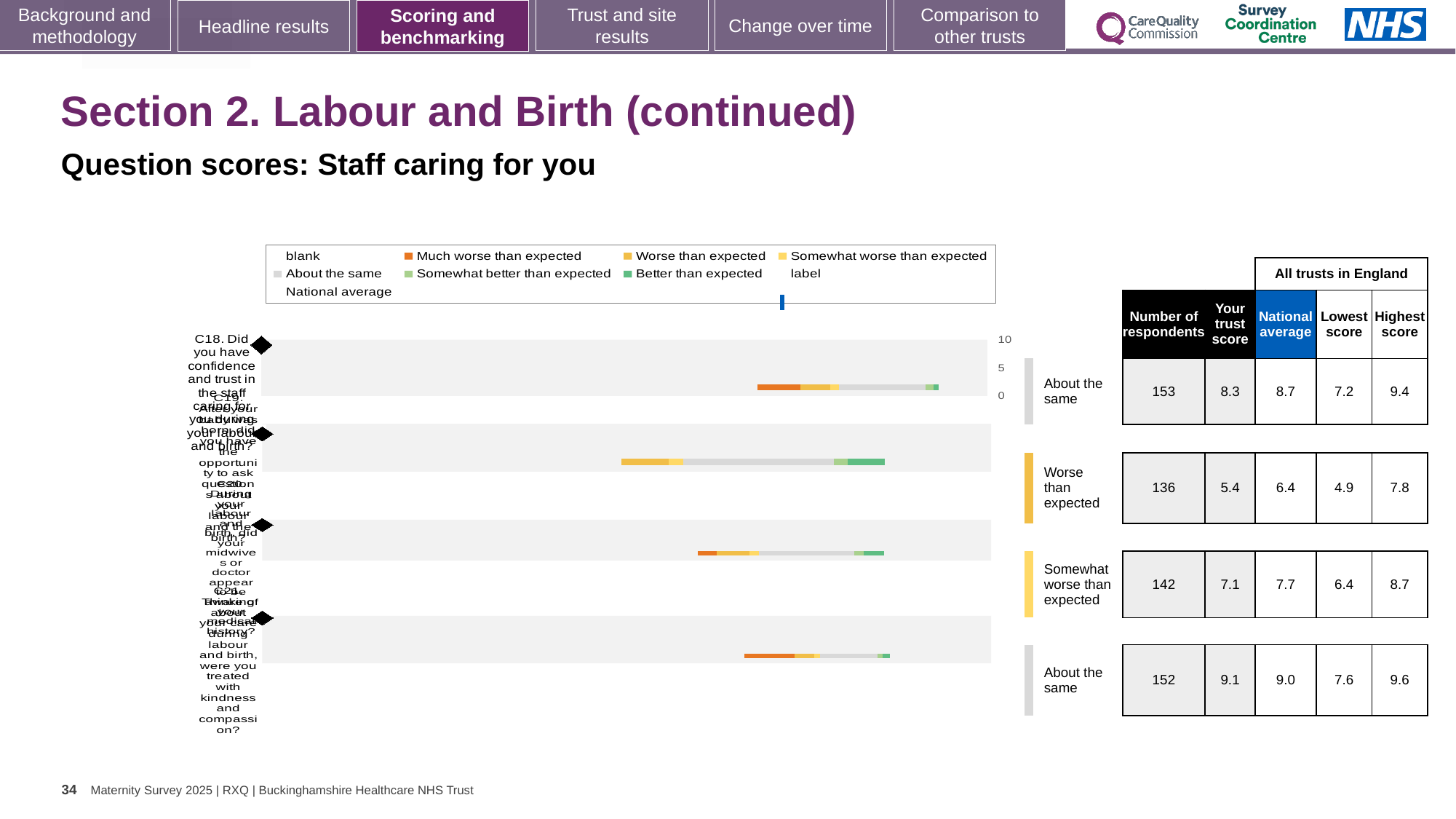
In the table, what is the highest score for the third row (142 respondents)? 8.7 In the table, what is the 'Your trust score' value in the first row (153 respondents)? 8.3 In the table, what is the national average for the row with 136 respondents? 6.4 Which row of the table has the highest 'Your trust score'? the fourth row (9.1) In the table, what is the lowest score for the fourth row (152 respondents)? 7.6 How many question rows are shown in the table on the right of the slide? 4 What kind of chart is shown on the slide? bar chart Which row of the table has the lowest 'Your trust score'? the second row (5.4) How many respondents are listed in the third row of the table? 142 In the second row of the table, how much higher is the national average than the trust score? 1.0 In the first row of the table, which is larger: the trust score or the national average? the national average (8.7) What benchmark category label is shown next to the second row of the table? Worse than expected